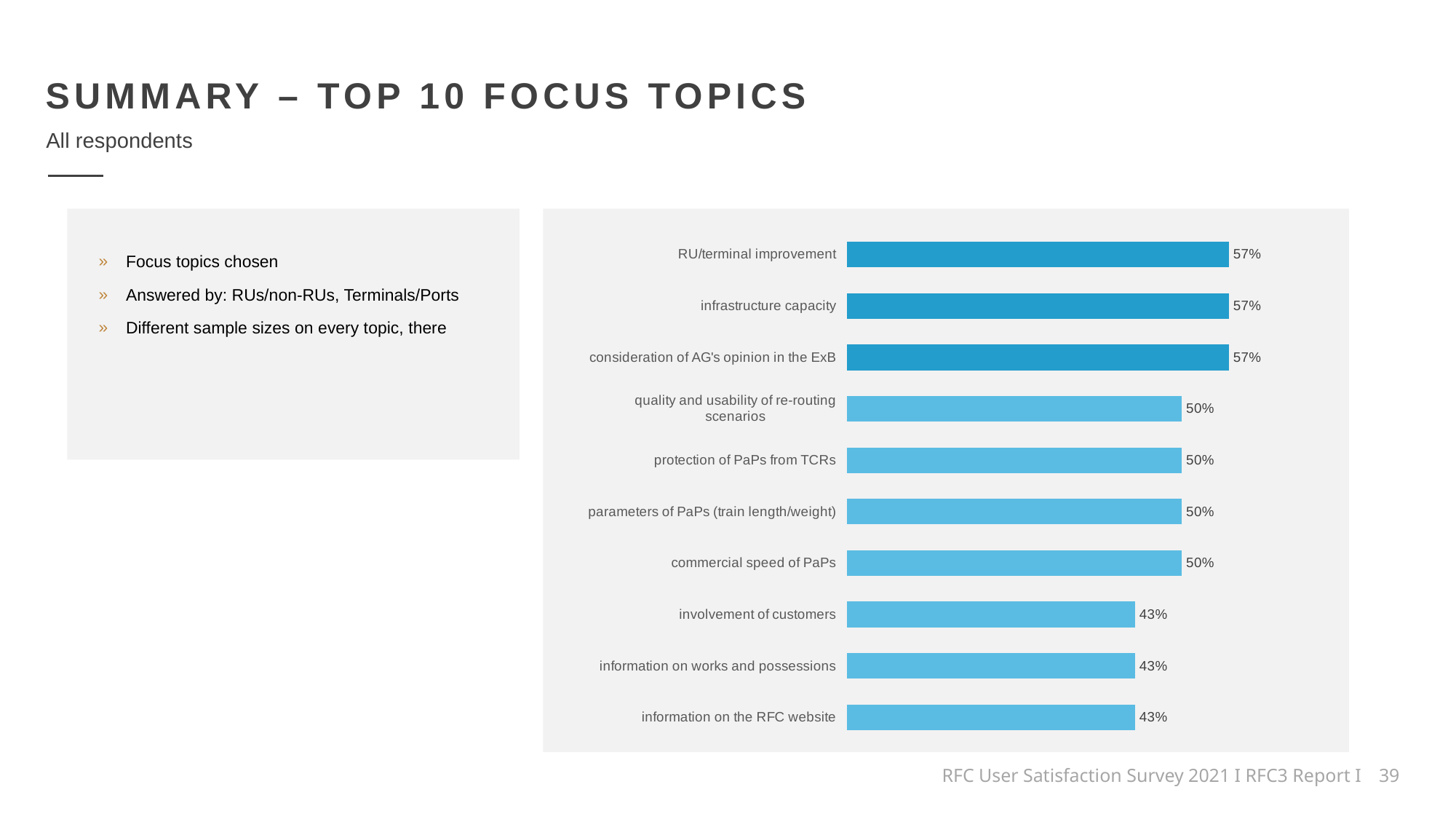
What is the value for commercial speed of PaPs? 50% What kind of chart is shown on the slide? bar chart What is the value for RU/terminal improvement? 57% How many categories are shown in the chart? 10 What is the value for information on the RFC website? 43% What is the value for quality and usability of re-routing scenarios? 50% What is the difference between the value for infrastructure capacity and the value for protection of PaPs from TCRs? 7% What is the difference between the value for consideration of AG's opinion in the ExB and the value for information on works and possessions? 14% Which is larger, the value for parameters of PaPs (train length/weight) or the value for involvement of customers? parameters of PaPs (train length/weight) What is the lowest value shown in the chart? 43% What is the value for involvement of customers? 43% How many categories share the highest value of 57%? 3